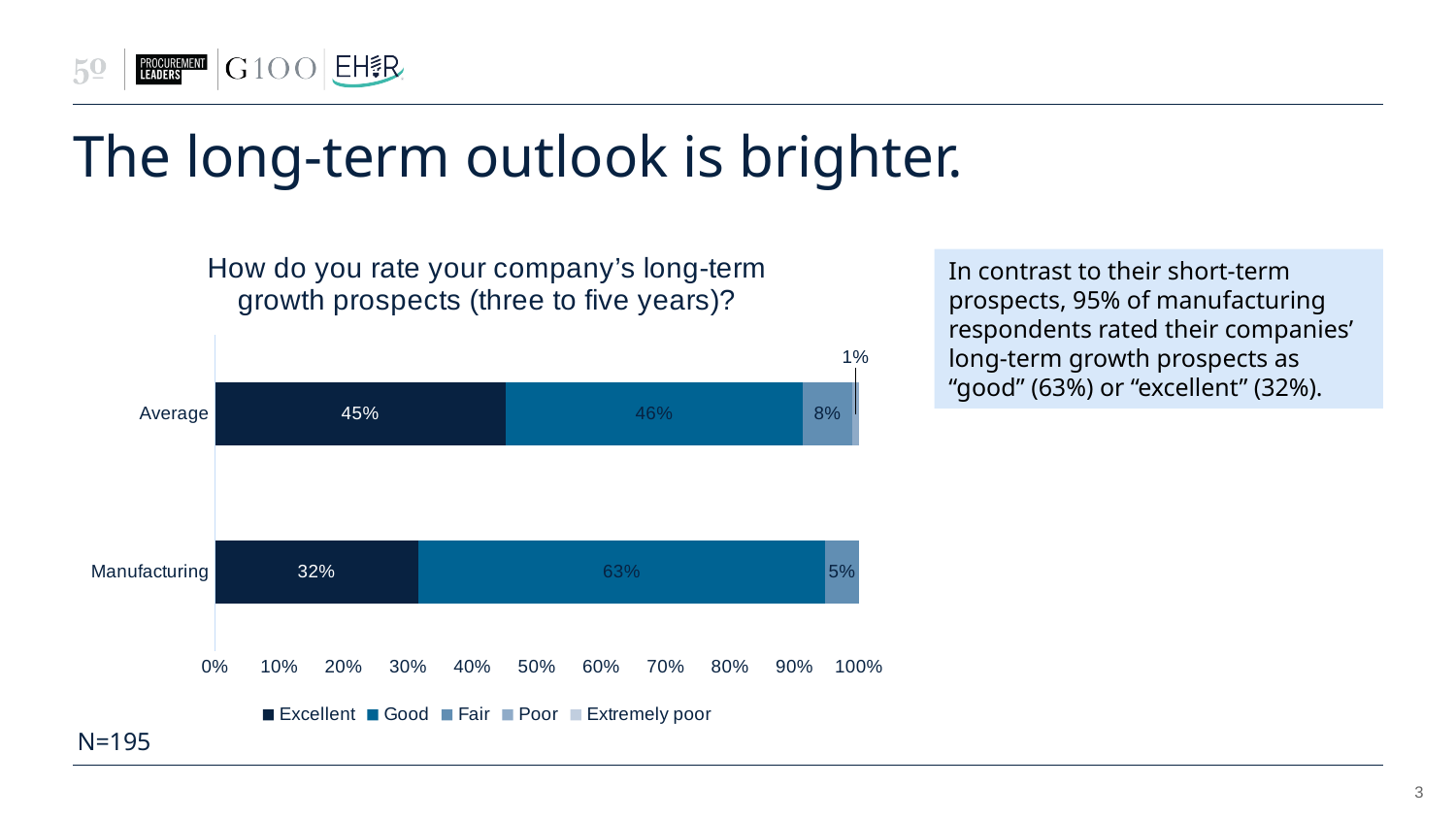
What percentage of Manufacturing respondents rated their long-term growth prospects as Good? 63% What is the Fair value for the Average bar? 8% What percentage of Average respondents rated their long-term growth prospects as Excellent? 45% Which category has the higher Good value, Average or Manufacturing? Manufacturing How many series does the chart legend list? 5 What is the Excellent value for the Manufacturing bar? 32% How many categories are shown on the y axis of the chart? 2 What type of chart is shown on the slide? Stacked bar chart What is the title of the chart? How do you rate your company's long-term growth prospects (three to five years)? What is the difference between the Excellent values for Average and Manufacturing? 13% What is the Fair value for the Manufacturing bar? 5% What is the combined Good and Excellent share for Manufacturing? 95%